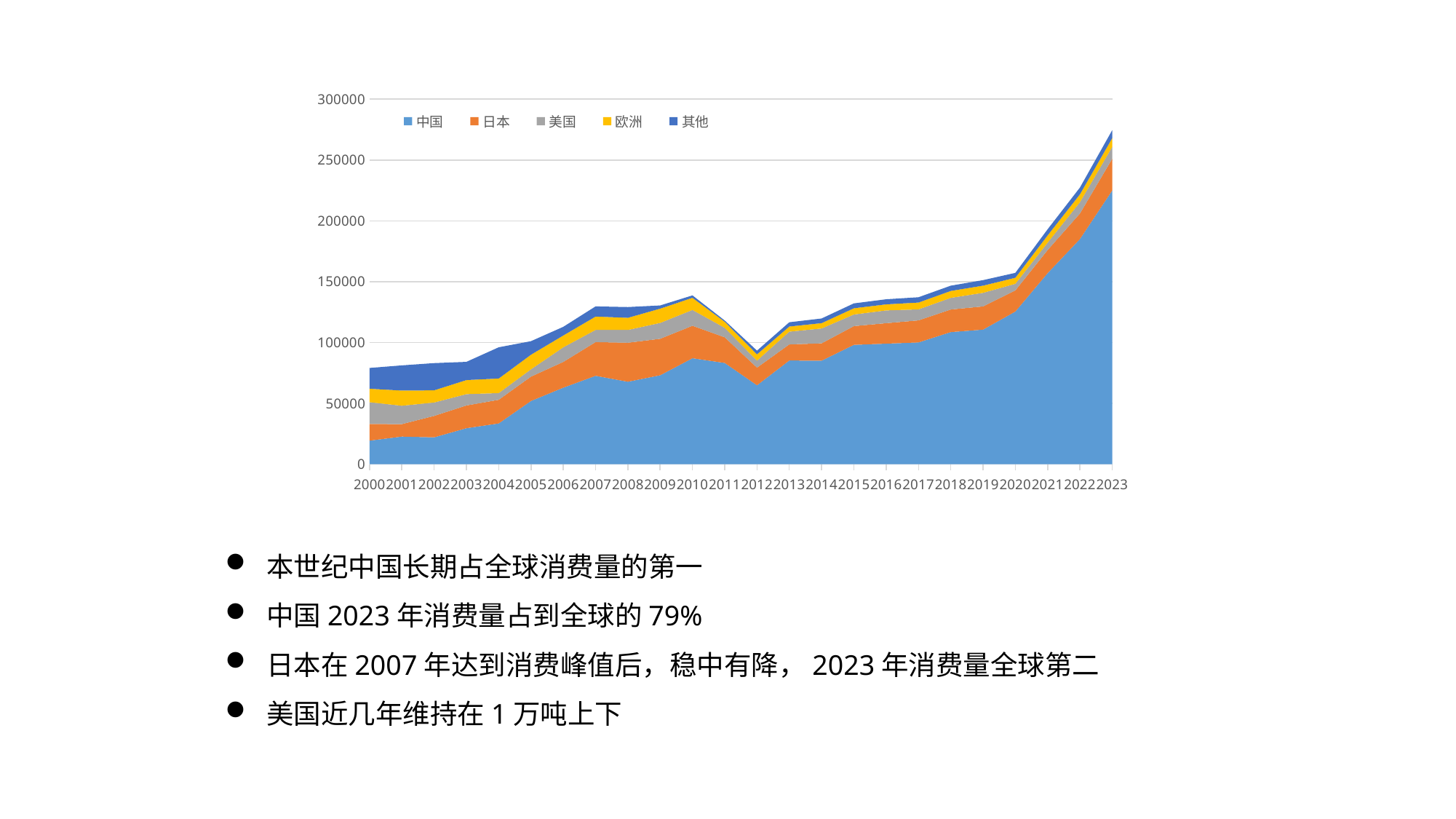
Which year has the lowest total stacked value? 2000 How many years are shown along the x axis? 24 How many series does the legend list? 5 Which series is listed first in the legend? 中国 Is the total stacked value for 2000 greater or less than 100000? less Overall, does the total stacked value rise or fall from 2000 to 2023? rise Is the total stacked value for 2023 greater or less than 250000? greater Is the value for 中国 in 2023 greater or less than 200000? greater What kind of chart is shown on the slide? stacked area chart In 2023, which series has the larger value, 中国 or 日本? 中国 Which year has the highest total stacked value? 2023